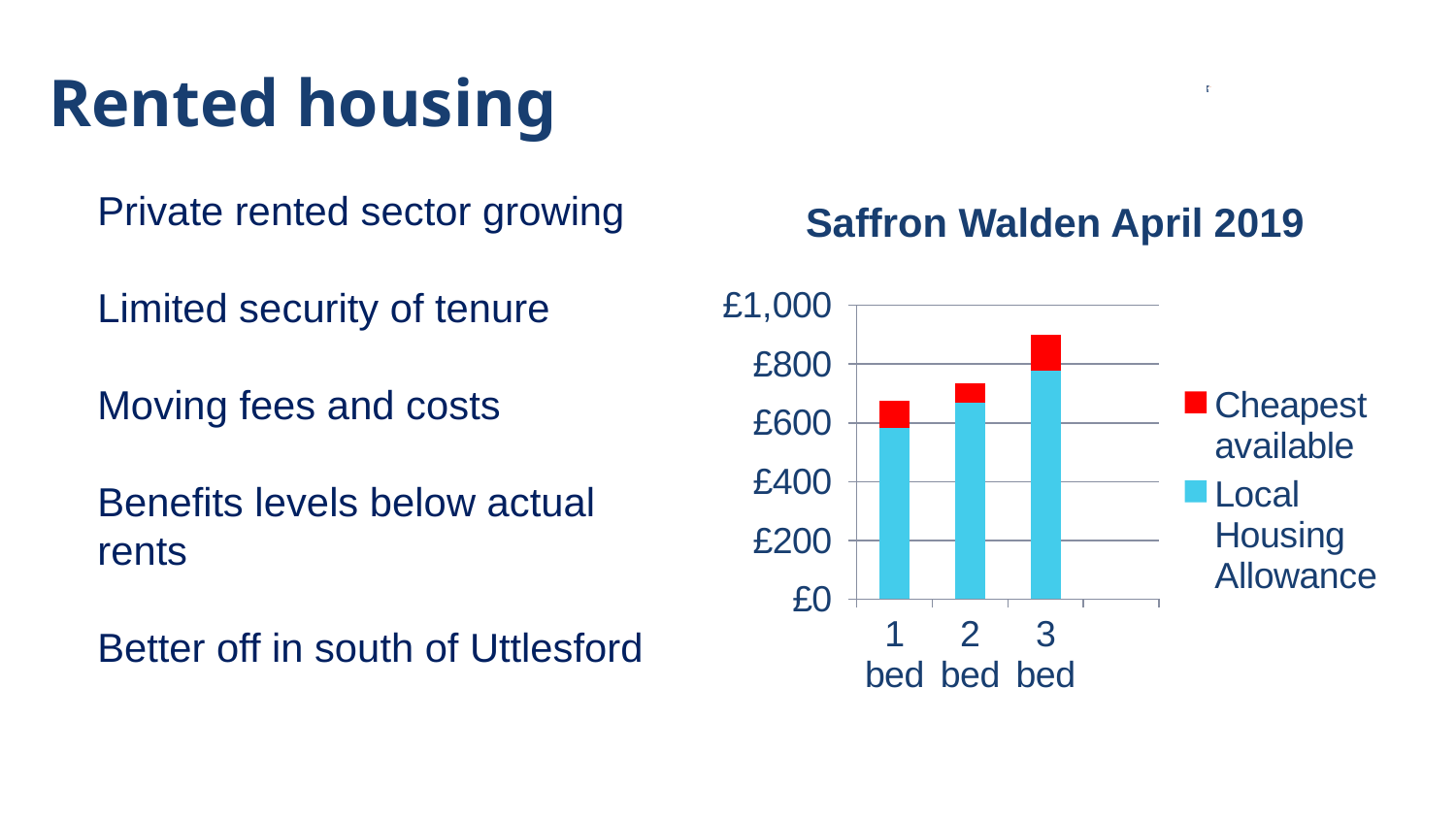
What is the title of the chart? Saffron Walden April 2019 What kind of chart is shown on the slide? Stacked bar chart Which category has the tallest stacked bar? 3 bed Is the Local Housing Allowance value for 3 bed greater or less than £600? greater How many series does the chart's legend list? 2 Is the total stacked value for 3 bed greater or less than £800? greater How many categories are shown on the x axis of the chart? 3 Do the stacked bar totals rise or fall from 1 bed to 3 bed? Rise Which colour represents the Cheapest available series in the chart? Red Is the total stacked value for 1 bed greater or less than £800? less Which category has the shortest stacked bar? 1 bed